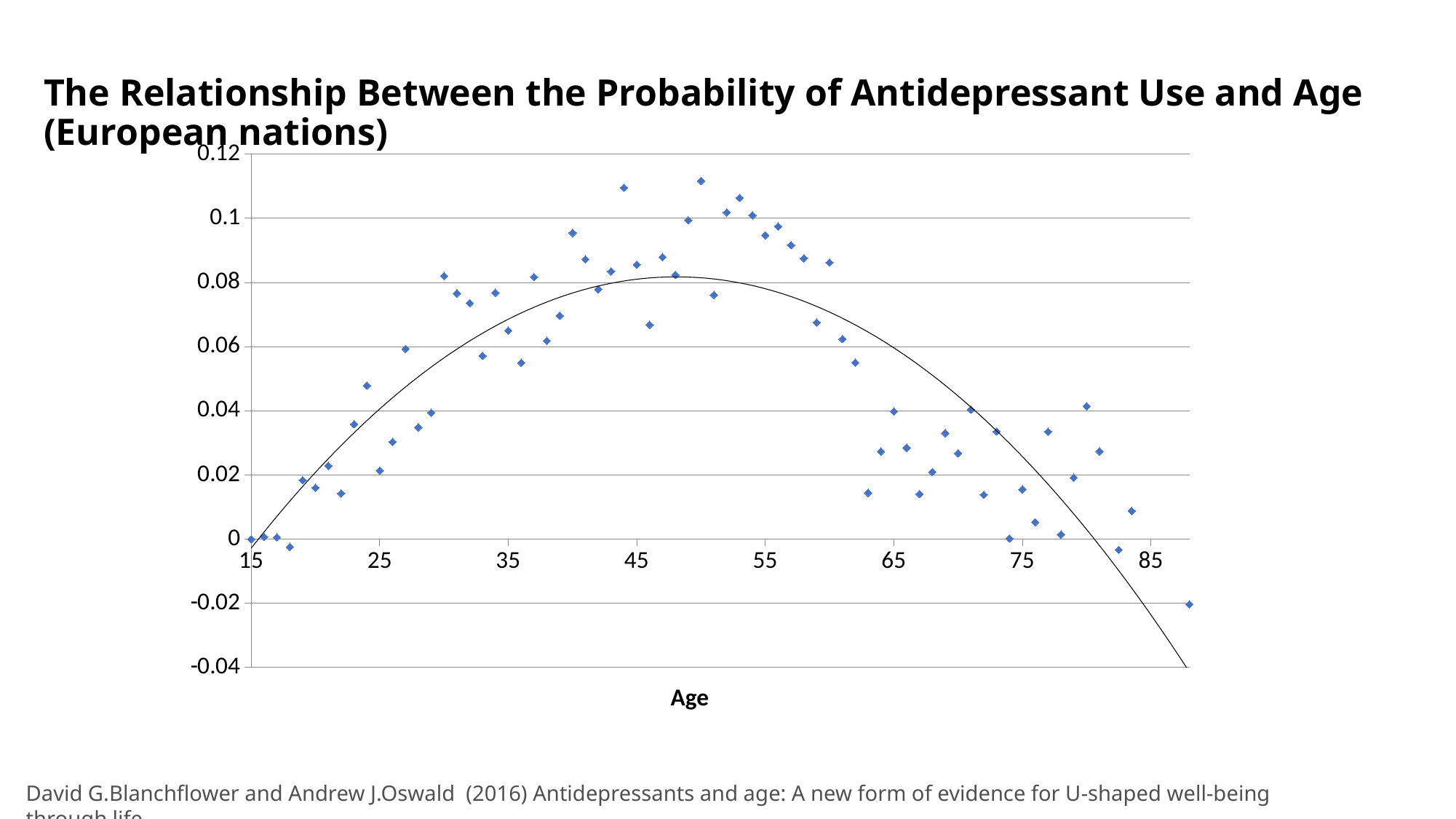
What kind of chart is shown on the slide? scatter chart Is the lowest plotted point at the youngest or the oldest age shown? oldest Between ages 15 and 45, do the plotted values generally rise or fall? rise What is the title of the x axis? Age Which has the larger plotted value, age 50 or age 75? age 50 Between ages 55 and 85, do the plotted values generally rise or fall? fall Is the plotted value at age 55 greater or less than 0.08? greater What is the highest value labelled on the y axis? 0.12 Is the plotted value at age 45 greater or less than 0.08? greater Which has the larger plotted value, age 20 or age 30? age 30 Is the plotted value at age 35 greater or less than 0.06? greater